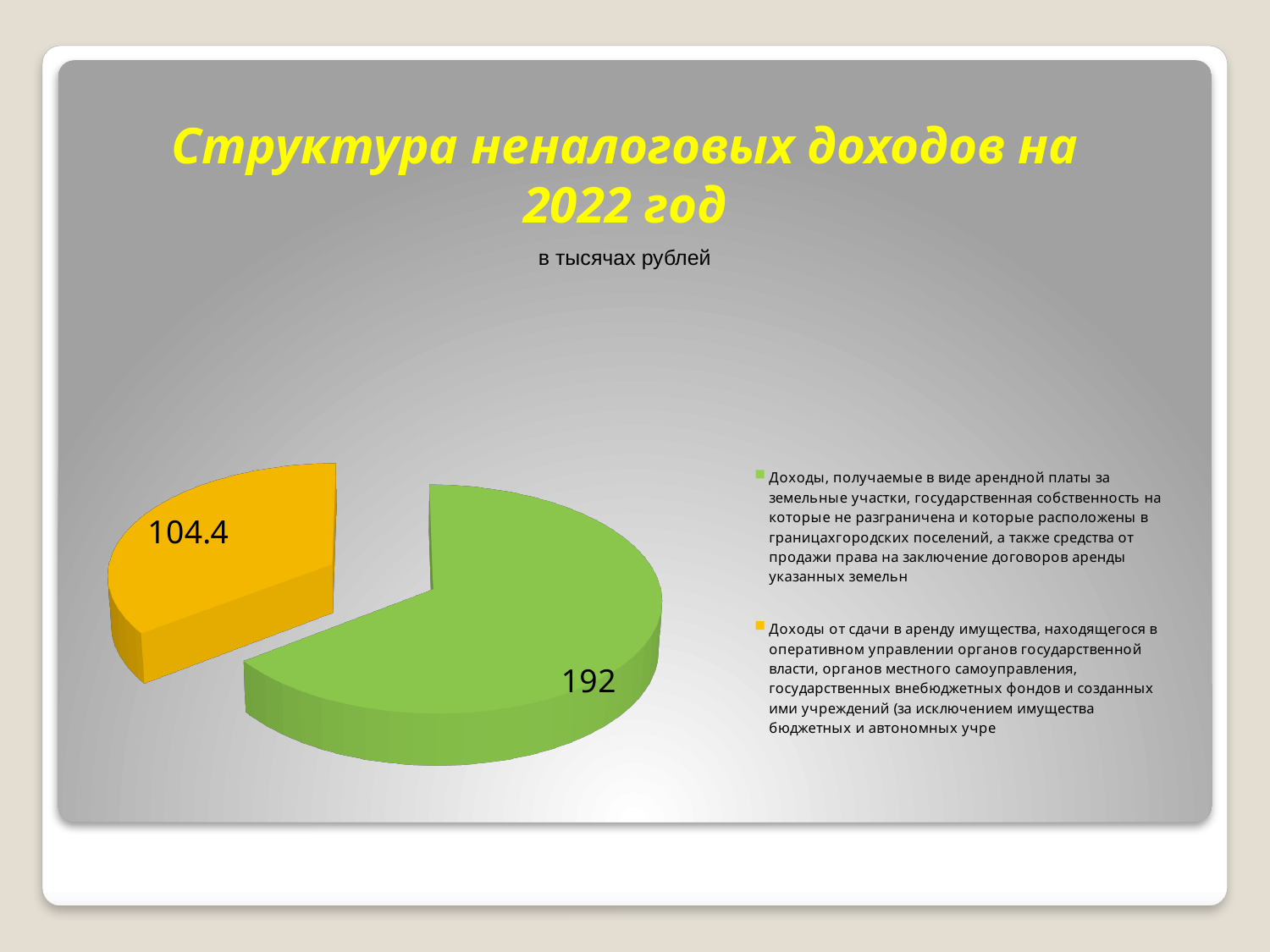
In what units are the values on the chart given? в тысячах рублей How many entries does the legend list? 2 Which category has the largest slice of the pie? Доходы, получаемые в виде арендной платы за земельные участки Which category has the smallest slice of the pie? Доходы от сдачи в аренду имущества What is the value of the orange slice (Доходы от сдачи в аренду имущества)? 104.4 What is the value of the green slice (Доходы, получаемые в виде арендной платы за земельные участки)? 192 What is the difference between the two slice values, 192 and 104.4? 87.6 What is the total of the two slice values shown on the pie chart? 296.4 What is the title of the chart on the slide? Структура неналоговых доходов на 2022 год Which is larger: income from land lease (green) or income from leasing property (orange)? Income from land lease (green), 192 How many slices does the pie chart have? 2 What type of chart is shown on the slide? Pie chart